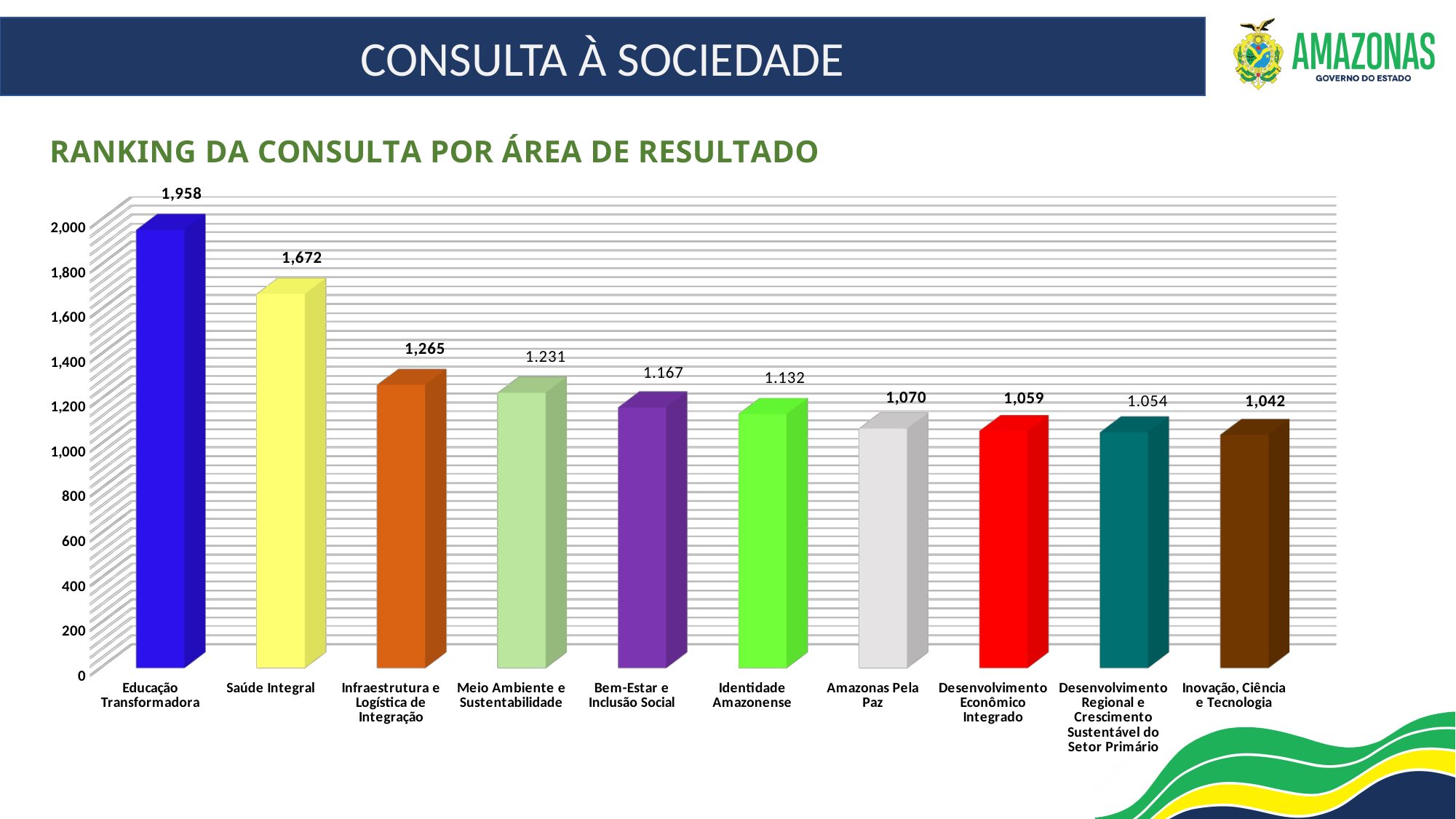
What is the value for Saúde Integral? 1,672 Which area has the highest value? Educação Transformadora Which is larger, the value for Infraestrutura e Logística de Integração or the value for Bem-Estar e Inclusão Social? Infraestrutura e Logística de Integração What kind of chart is shown on the slide? bar chart What is the title of the chart? RANKING DA CONSULTA POR ÁREA DE RESULTADO What is the value for Meio Ambiente e Sustentabilidade? 1.231 What is the difference between the values for Educação Transformadora and Saúde Integral? 286 What is the value for Educação Transformadora? 1,958 What is the value for Amazonas Pela Paz? 1,070 Is the value for Identidade Amazonense greater or less than 1,000? greater How many areas are shown in the chart? 10 Which area has the lowest value? Inovação, Ciência e Tecnologia